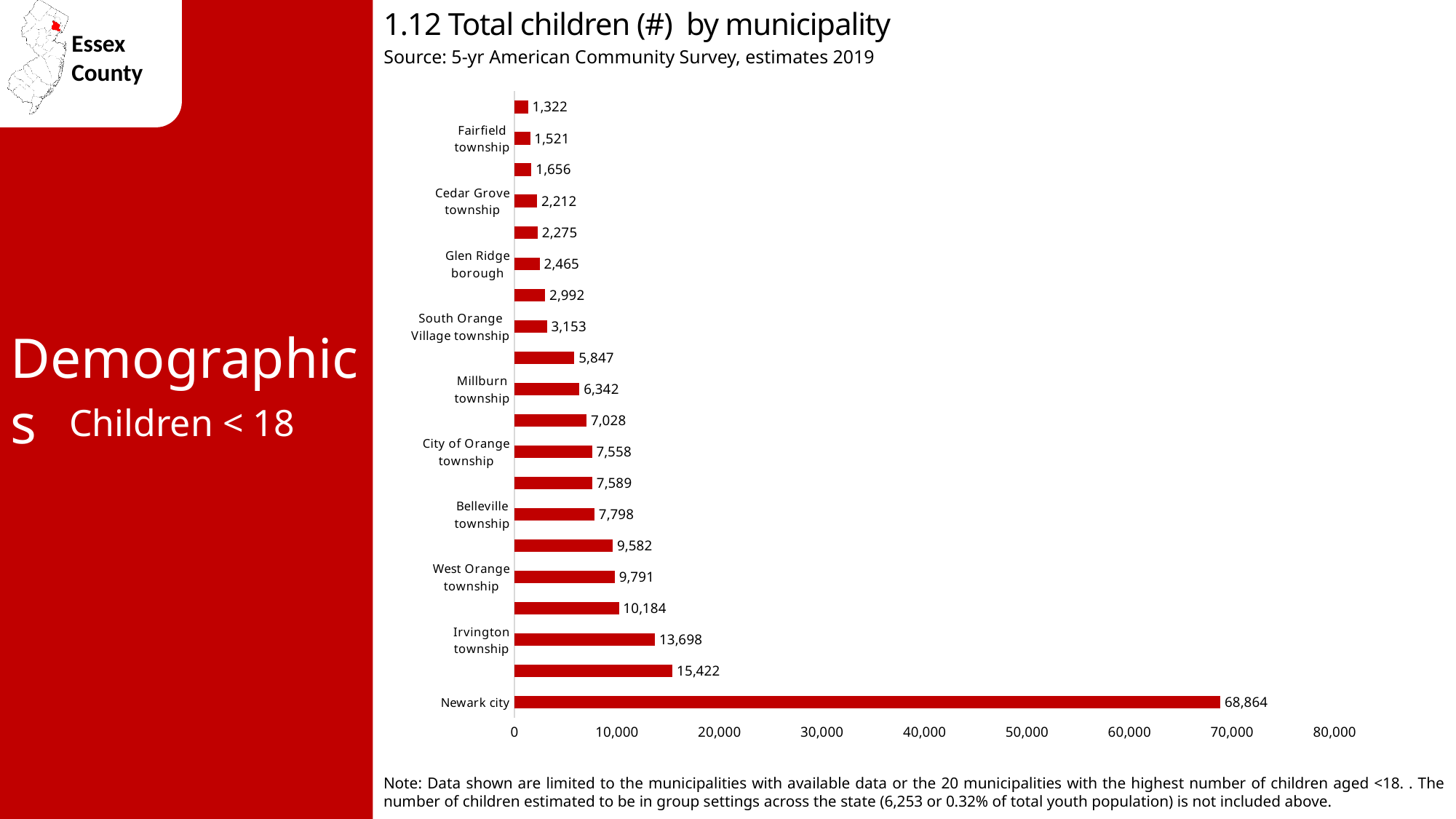
What is the total number of children for West Orange township? 9,791 What is the total number of children for Millburn township? 6,342 Which has more children, Belleville township or Millburn township? Belleville township What type of chart is shown on the slide? Bar chart Is the value for Newark city greater or less than 60,000? greater What is the total number of children for Irvington township? 13,698 Which municipality has the highest number of children? Newark city What is the total number of children for Fairfield township? 1,521 What is the smallest value shown on the chart? 1,322 How many bars are shown on the chart? 20 How many more children does Newark city have than Irvington township? 55,166 What is the total number of children for Newark city? 68,864